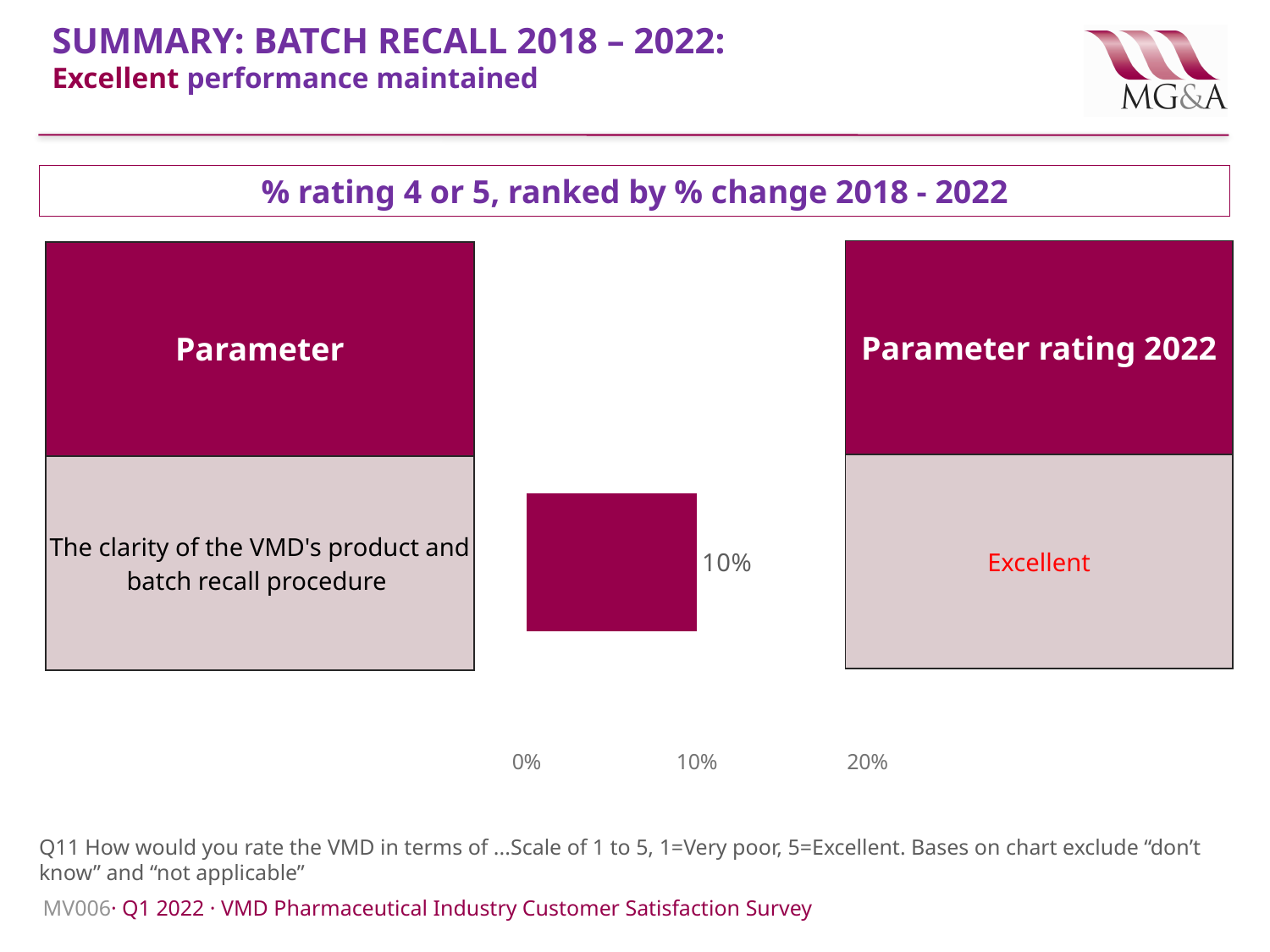
What kind of chart is shown on the slide? bar chart How many parameters (bars) are plotted in the chart? 1 What is the title of the chart? % rating 4 or 5, ranked by % change 2018 - 2022 Is the value for 'The clarity of the VMD's product and batch recall procedure' greater or less than 20%? less What is the % change 2018 - 2022 shown for 'The clarity of the VMD's product and batch recall procedure'? 10% Is the value for 'The clarity of the VMD's product and batch recall procedure' greater or less than 0%? greater What is the highest value shown on the chart's x axis? 20% Which parameter is plotted in the chart? The clarity of the VMD's product and batch recall procedure What is the parameter rating 2022 given for 'The clarity of the VMD's product and batch recall procedure'? Excellent